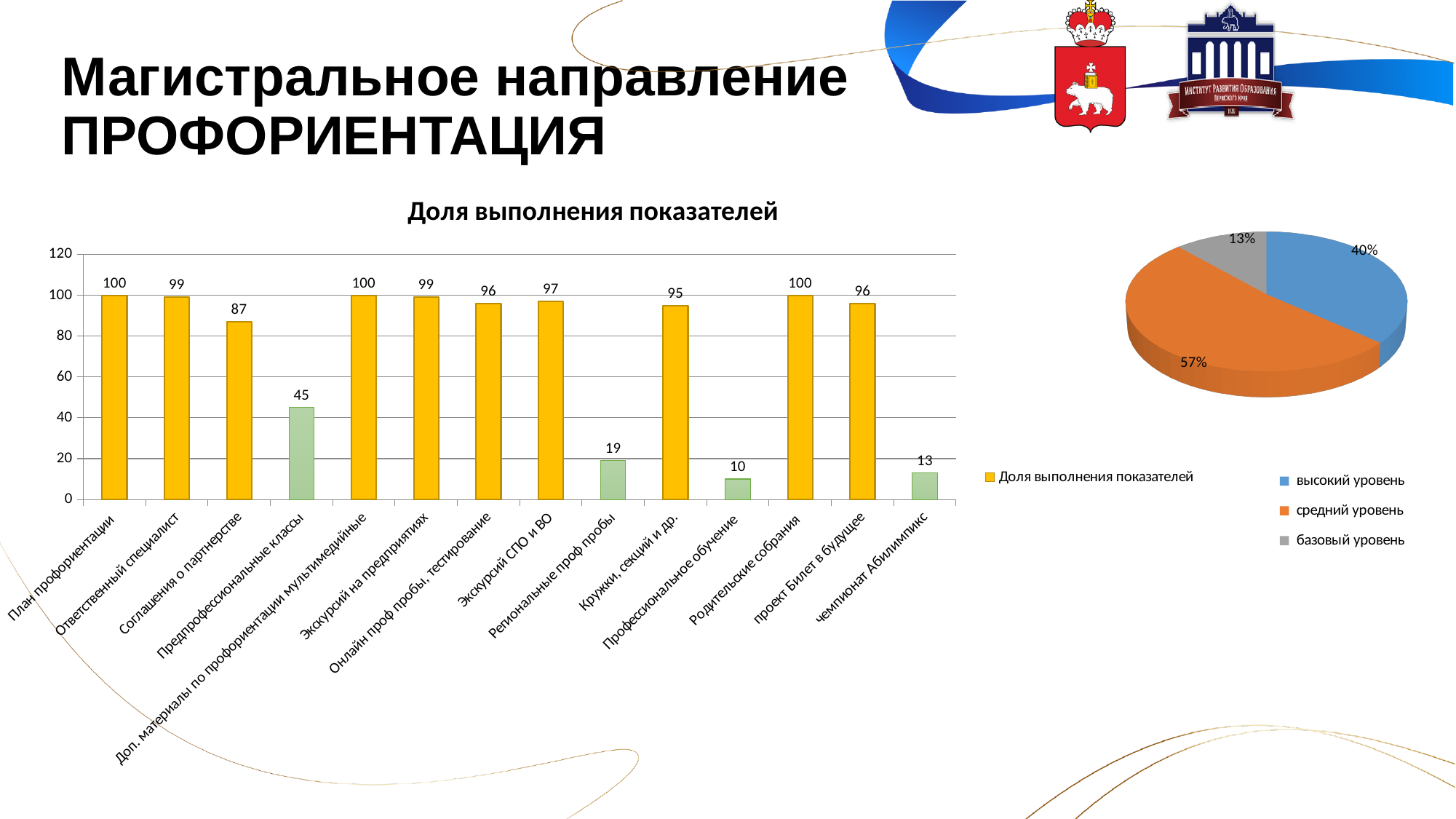
How many entries does the legend of the pie chart on the right list? 3 In the bar chart 'Доля выполнения показателей', what is the value for 'Региональные проф пробы'? 19 What kind of chart is the chart on the right side of the slide? Pie chart In the bar chart 'Доля выполнения показателей', what is the value for 'Соглашения о партнерстве'? 87 In the bar chart 'Доля выполнения показателей', what is the difference between 'Экскурсий СПО и ВО' and 'чемпионат Абилимпикс'? 84 In the pie chart on the right, what share does 'средний уровень' have? 57% In the bar chart 'Доля выполнения показателей', which is larger: 'Кружки, секций и др.' or 'Ответственный специалист'? Ответственный специалист In the pie chart on the right, which level has the smallest share? базовый уровень In the bar chart 'Доля выполнения показателей', which category has the lowest value? Профессиональное обучение In the bar chart 'Доля выполнения показателей', what is the value for 'Предпрофессиональные классы'? 45 How many categories are shown in the bar chart 'Доля выполнения показателей'? 14 In the bar chart 'Доля выполнения показателей', what is the highest value shown? 100